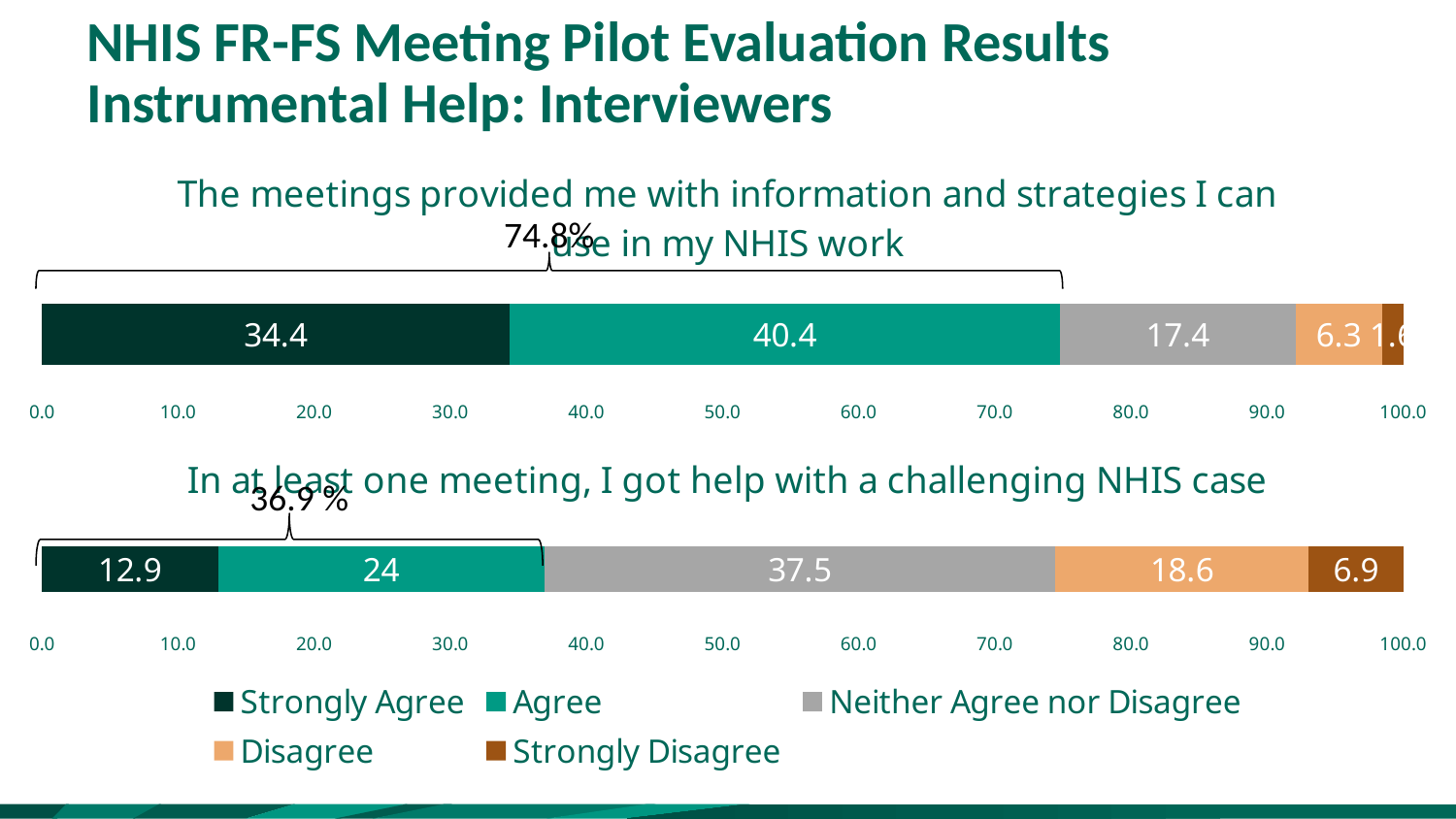
Which is larger: the Strongly Agree value in the top chart or the Strongly Agree value in the bottom chart? The top chart (34.4) In the chart titled "In at least one meeting, I got help with a challenging NHIS case", what is the difference between the Agree and Strongly Agree values? 11.1 In the chart titled "In at least one meeting, I got help with a challenging NHIS case", which response category has the smallest value? Strongly Disagree In the chart titled "The meetings provided me with information and strategies I can use in my NHIS work", which response category has the largest value? Agree In the chart titled "The meetings provided me with information and strategies I can use in my NHIS work", what is the difference between the Agree and Neither Agree nor Disagree values? 23 What type of chart is used on this slide? Stacked bar chart In the chart titled "In at least one meeting, I got help with a challenging NHIS case", what is the value for Disagree? 18.6 In the chart titled "The meetings provided me with information and strategies I can use in my NHIS work", what is the value for Strongly Agree? 34.4 How many series does the legend list? 5 In the chart titled "The meetings provided me with information and strategies I can use in my NHIS work", what is the value for Agree? 40.4 In the chart titled "In at least one meeting, I got help with a challenging NHIS case", what is the value for Neither Agree nor Disagree? 37.5 In the chart titled "In at least one meeting, I got help with a challenging NHIS case", which response category has the largest value? Neither Agree nor Disagree